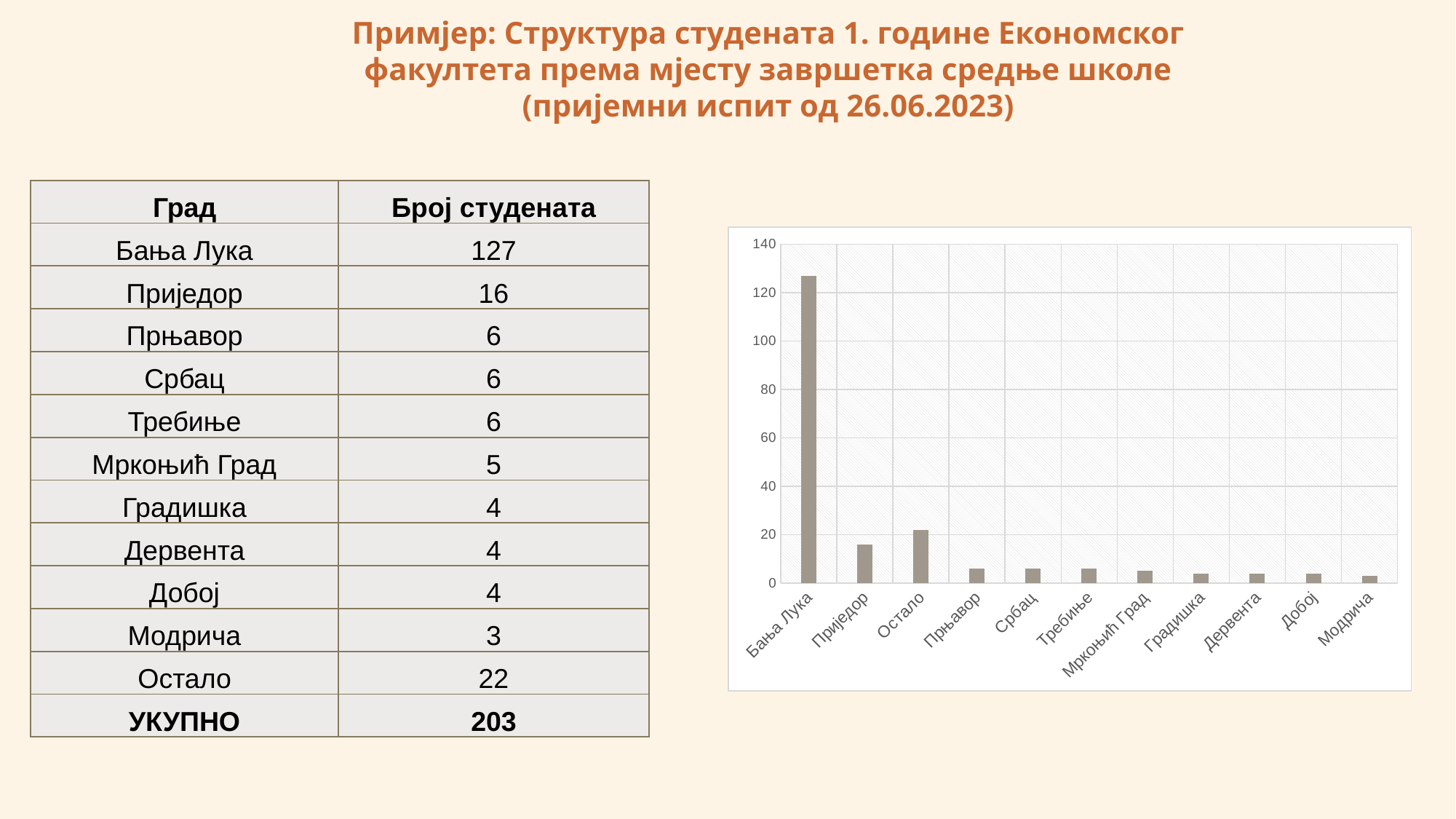
What is the difference between the values for Бања Лука and Остало? 105 What is the value for Приједор? 16 Which category has the lowest bar in the chart? Модрича Which is larger, the value for Остало or the value for Приједор? Остало What is the highest value shown on the vertical axis of the chart? 140 What is the value for Бања Лука? 127 What kind of chart is shown on the slide? bar chart Is the value for Бања Лука greater or less than 120? greater How many categories (bars) does the chart show? 11 What is the value for Остало? 22 Is the value for Приједор greater or less than 20? less Which category has the highest bar in the chart? Бања Лука